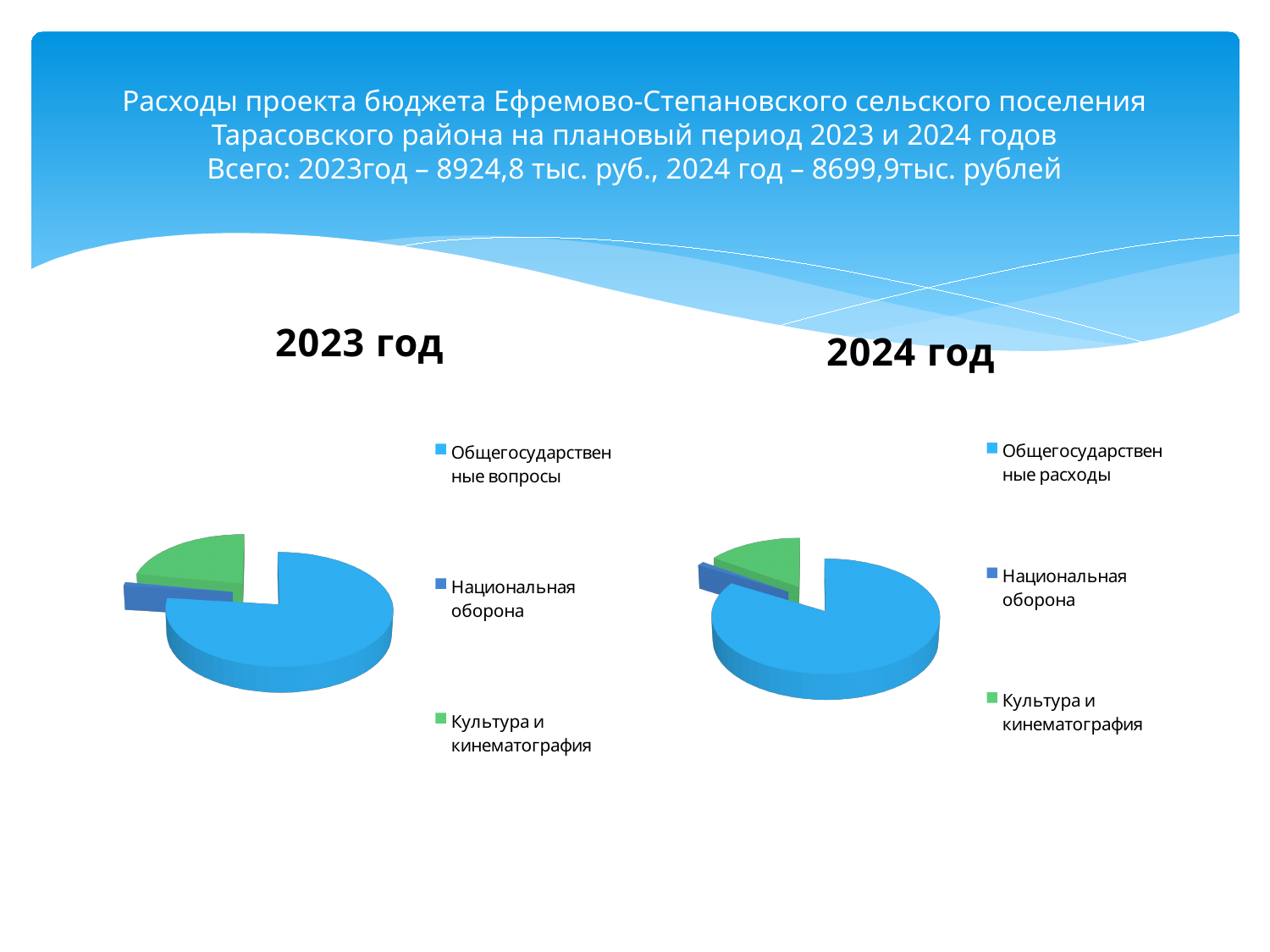
What kind of chart is the 2023 год chart? pie chart In the 2024 год chart, which is larger: the slice for Общегосударственные расходы or the slice for Культура и кинематография? Общегосударственные расходы In the 2023 год chart, which category has the largest slice? Общегосударственные вопросы In the 2023 год chart, which category has the smallest slice? Национальная оборона In the 2024 год chart, which category has the largest slice? Общегосударственные расходы In the 2023 год chart, which is larger: the slice for Культура и кинематография or the slice for Национальная оборона? Культура и кинематография In the 2024 год chart, what colour is the slice for Культура и кинематография? green In the 2024 год chart, which category has the smallest slice? Национальная оборона In the 2023 год chart, how many categories does the legend list? 3 In the 2023 год chart, what is the first legend entry? Общегосударственные вопросы In the 2024 год chart, how many slices does the pie have? 3 What kind of chart is the 2024 год chart? pie chart